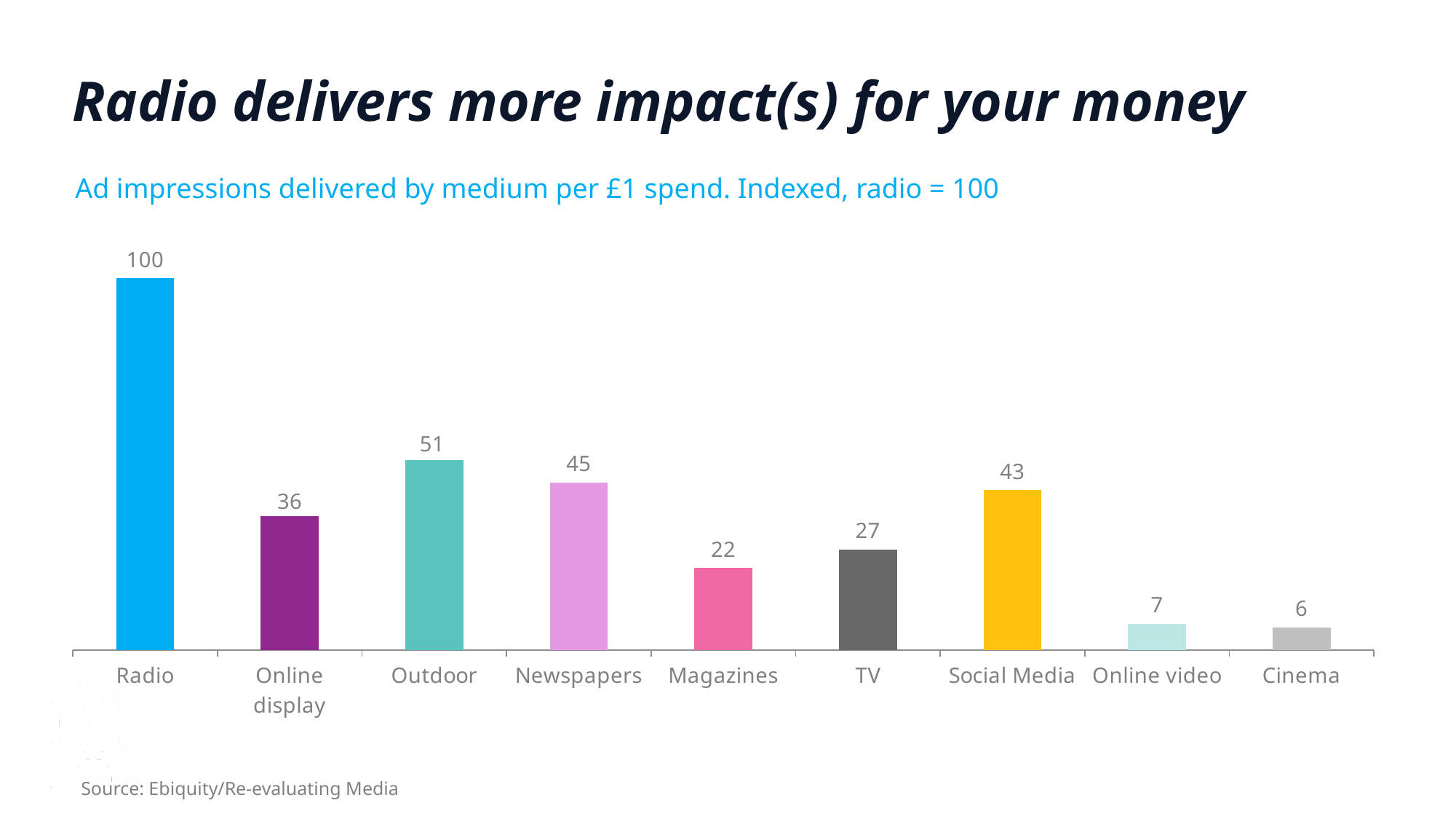
What is the indexed value for Social Media? 43 Which medium has the lowest indexed value? Cinema What is the indexed value for TV? 27 What type of chart is shown on the slide? Bar chart What is the difference between the values for Newspapers and Magazines? 23 What is the source cited for the chart? Ebiquity/Re-evaluating Media Which has a higher value, Online display or Social Media? Social Media What is the difference between the values for Radio and Outdoor? 49 How many media categories are shown in the chart? 9 What is the indexed value for Outdoor? 51 Which medium has the highest indexed value? Radio Which has a higher value, Online video or Cinema? Online video